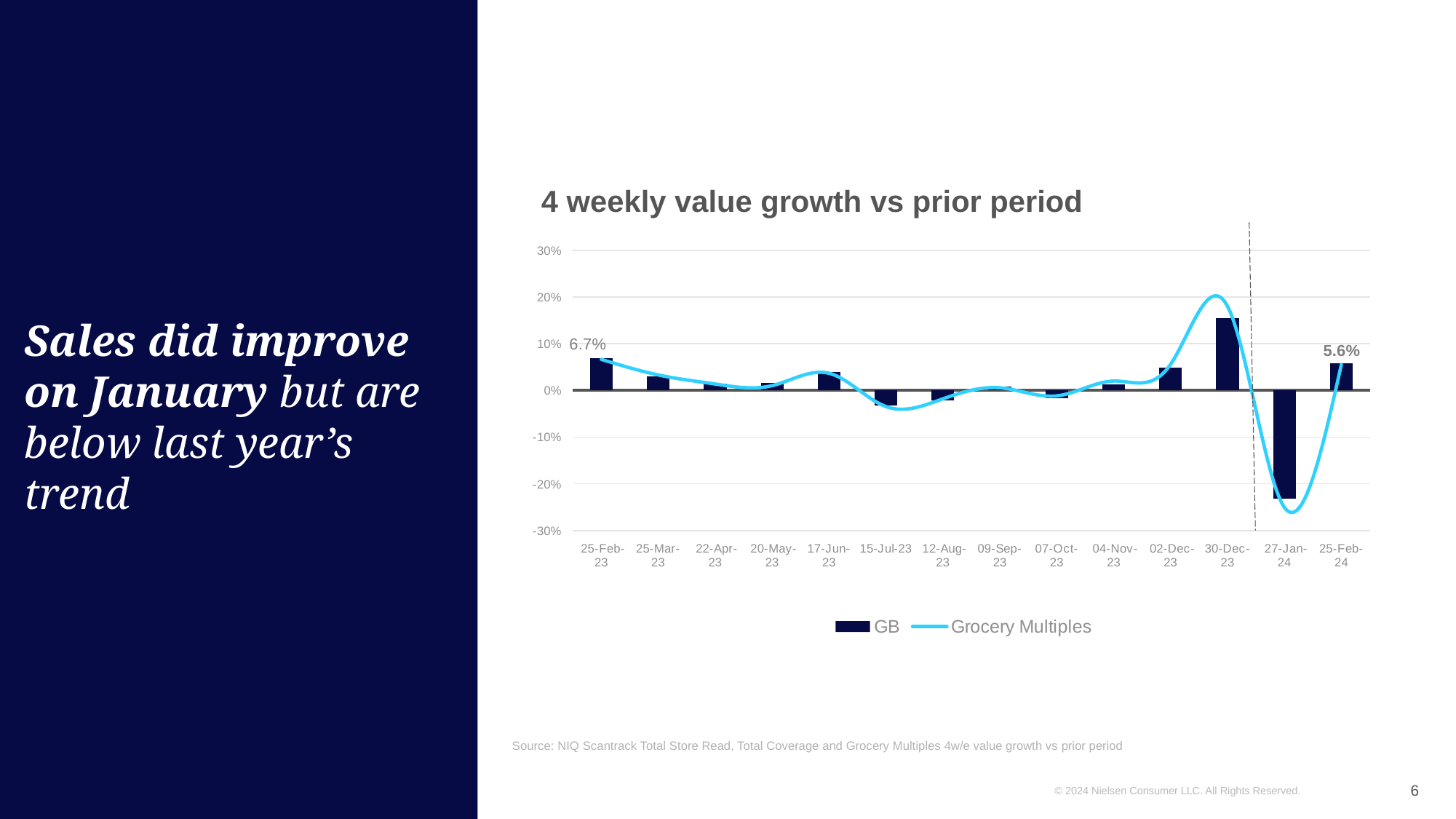
Which is larger, the GB value for 25-Feb-23 or for 25-Feb-24? 25-Feb-23 Which period has the highest GB bar? 30-Dec-23 How many series does the legend list? 2 Which period has the lowest GB bar? 27-Jan-24 How many periods are shown on the x axis? 14 Is the GB value for 30-Dec-23 greater or less than 10%? greater Is the GB value for 27-Jan-24 greater or less than -20%? less Is the Grocery Multiples value for 27-Jan-24 greater or less than -20%? less What is the title of the chart? 4 weekly value growth vs prior period